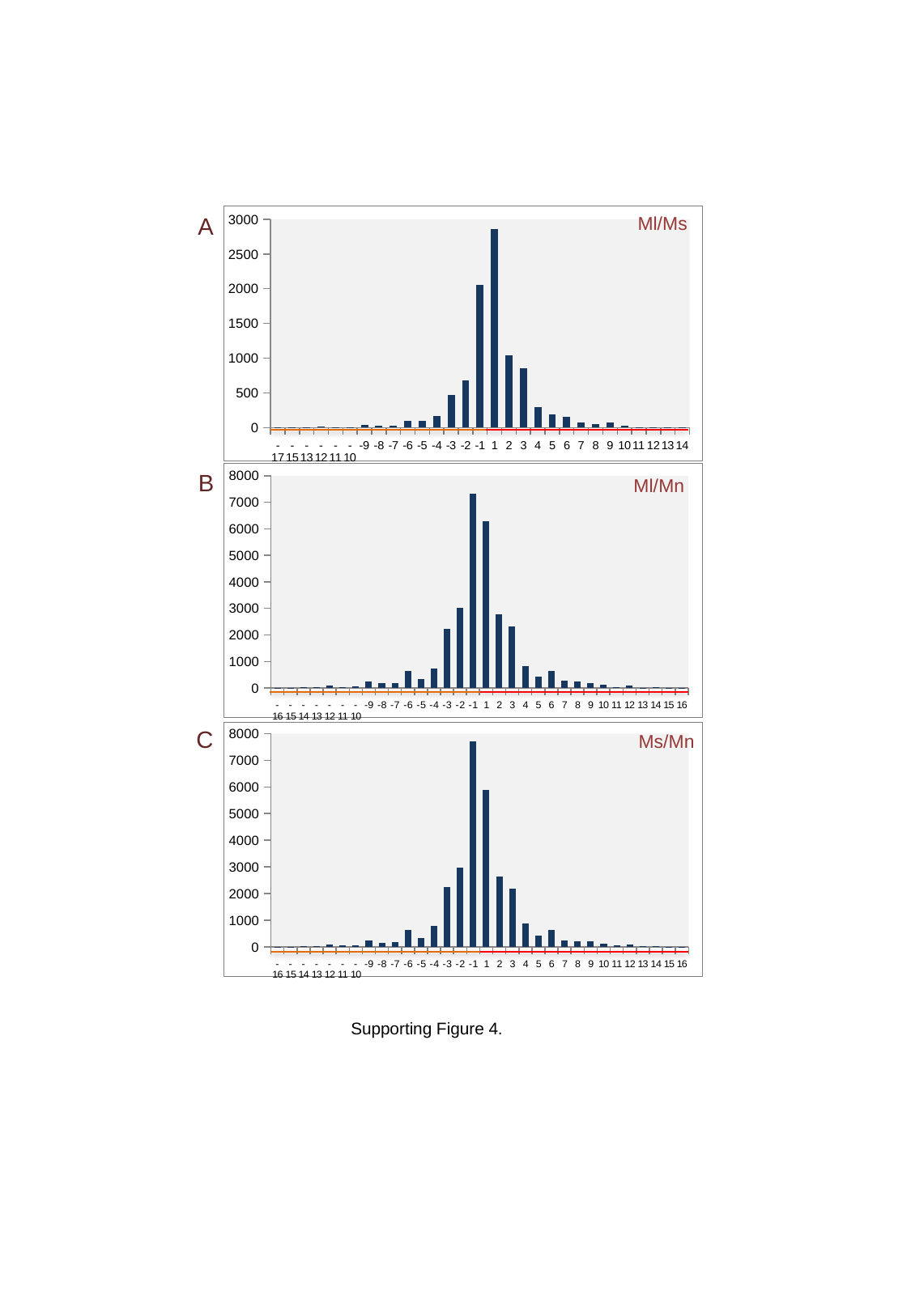
In chart C (Ms/Mn), which category has the highest bar? -1 In chart A (Ml/Ms), is the value for category 3 greater or less than 1000? less In chart A (Ml/Ms), is the value for category 1 greater or less than 2500? greater In chart B (Ml/Mn), which category has the highest bar? -1 In chart A (Ml/Ms), which category has the highest bar? 1 In chart B (Ml/Mn), is the value for category -1 greater or less than 7000? greater What is the label shown in the top-right corner of chart C? Ms/Mn In chart B (Ml/Mn), which is larger, the value for category -1 or the value for category 1? -1 In chart A (Ml/Ms), which is larger, the value for category -1 or the value for category 2? -1 What kind of chart is chart A (Ml/Ms)? bar chart